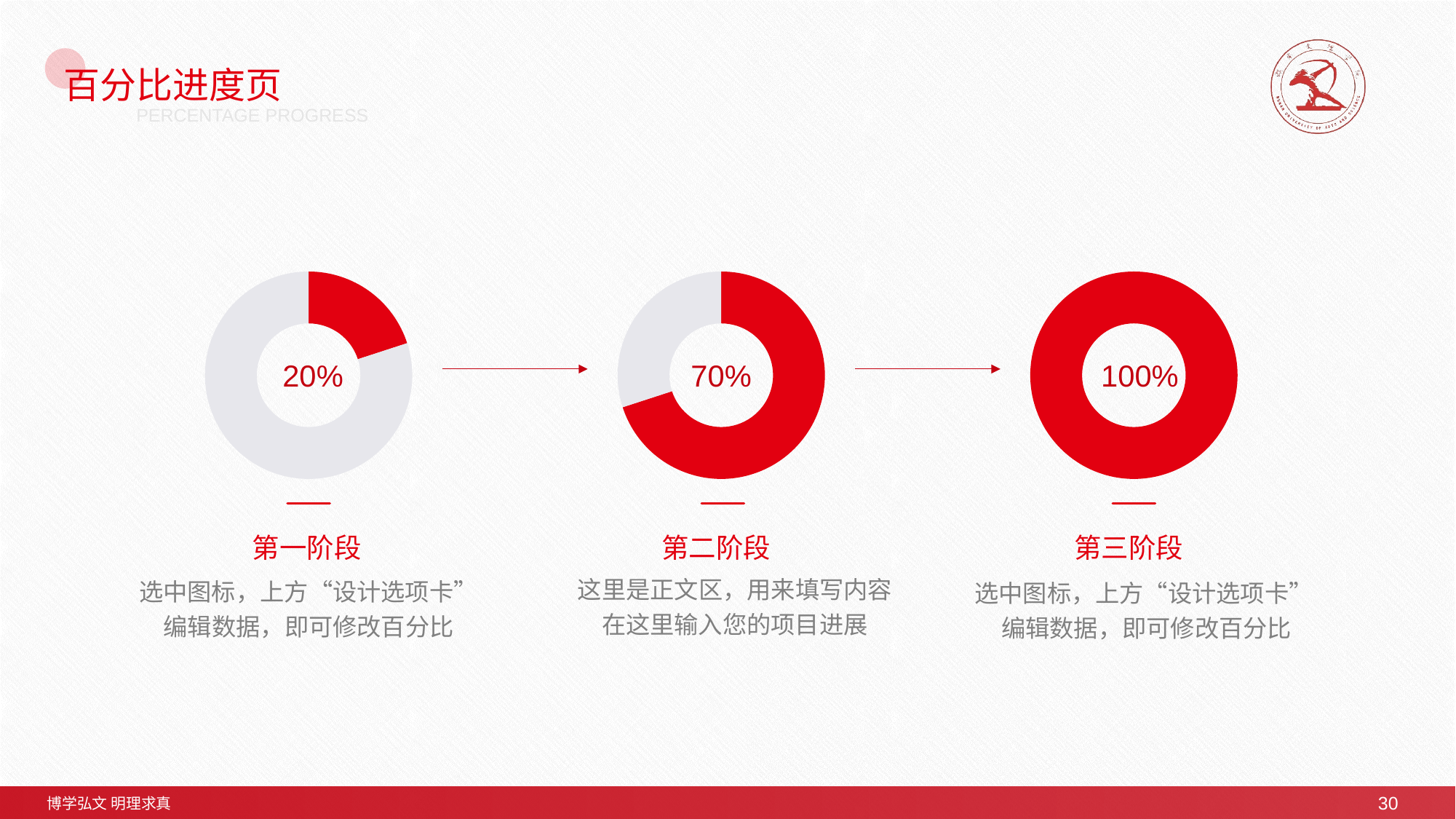
What kind of chart is used to show each stage's percentage? Donut chart Which is larger, the percentage for 第一阶段 or the percentage for 第二阶段? 第二阶段 What percentage is shown in the donut chart for 第一阶段? 20% What is the difference between the percentage for 第三阶段 and the percentage for 第二阶段? 30% What percentage is shown in the donut chart for 第三阶段? 100% What percentage is shown in the donut chart for 第二阶段? 70% How many donut charts are shown on the slide? 3 What colour is the filled (completed) portion of each donut chart? Red Which stage's donut chart shows the lowest percentage? 第一阶段 Do the percentages rise or fall from 第一阶段 to 第三阶段? Rise What is the difference between the percentage for 第二阶段 and the percentage for 第一阶段? 50% Which stage's donut chart shows the highest percentage? 第三阶段